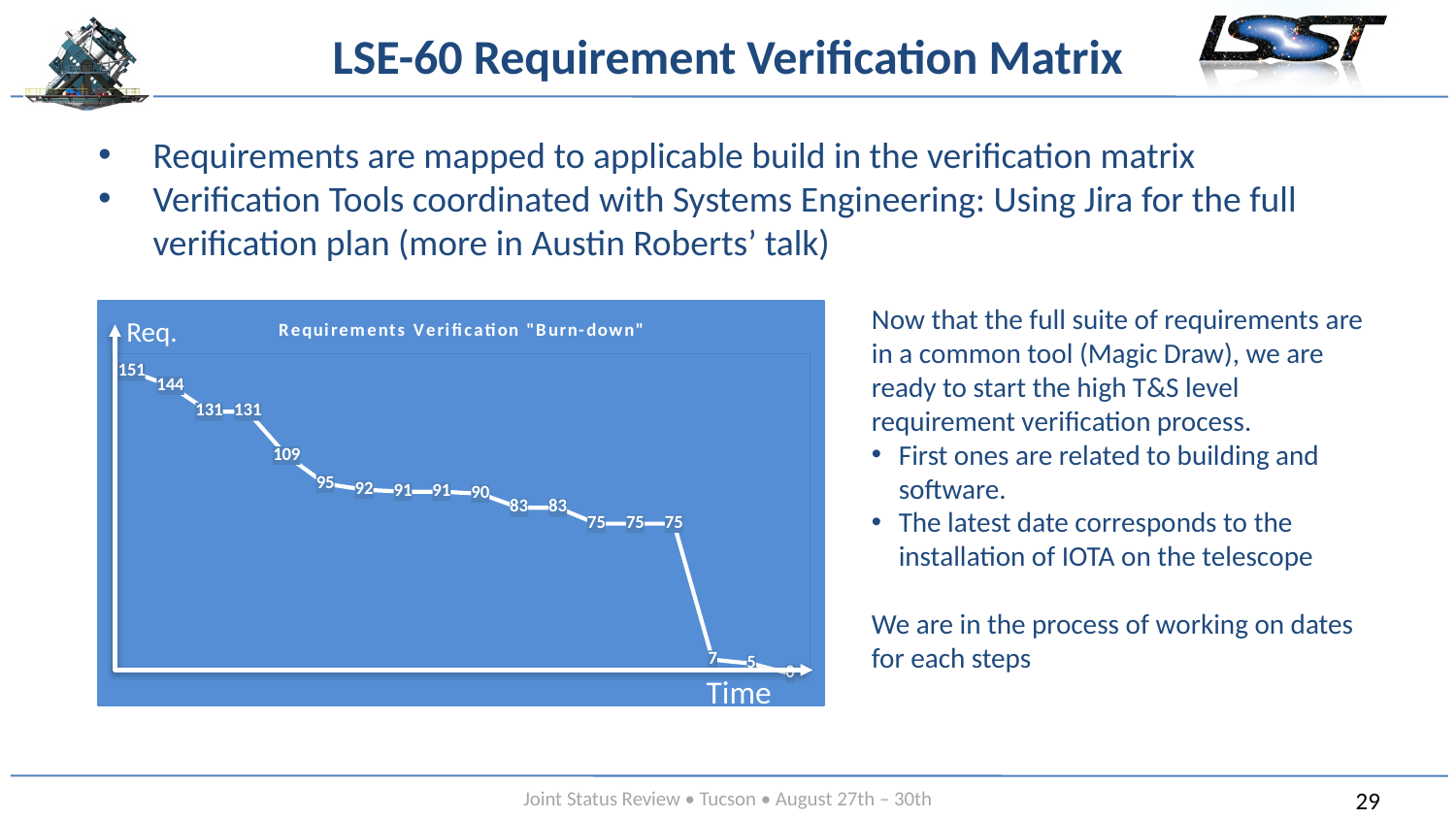
What is the title of the chart? Requirements Verification "Burn-down" What is the value of the second data point in the chart? 144 What is the label on the vertical axis of the chart? Req. What kind of chart is shown on the slide? line chart How many data points are plotted in the chart? 18 Which is larger, the data point labelled 144 or the data point labelled 109? 144 What is the difference between the first data point (151) and the last data point (0) in the chart? 151 Do the values in the chart rise or fall along the x axis? fall What is the lowest value plotted in the chart? 0 What is the difference between the data point labelled 109 and the next data point labelled 95? 14 What is the highest value plotted in the chart? 151 What is the value of the first data point in the chart? 151